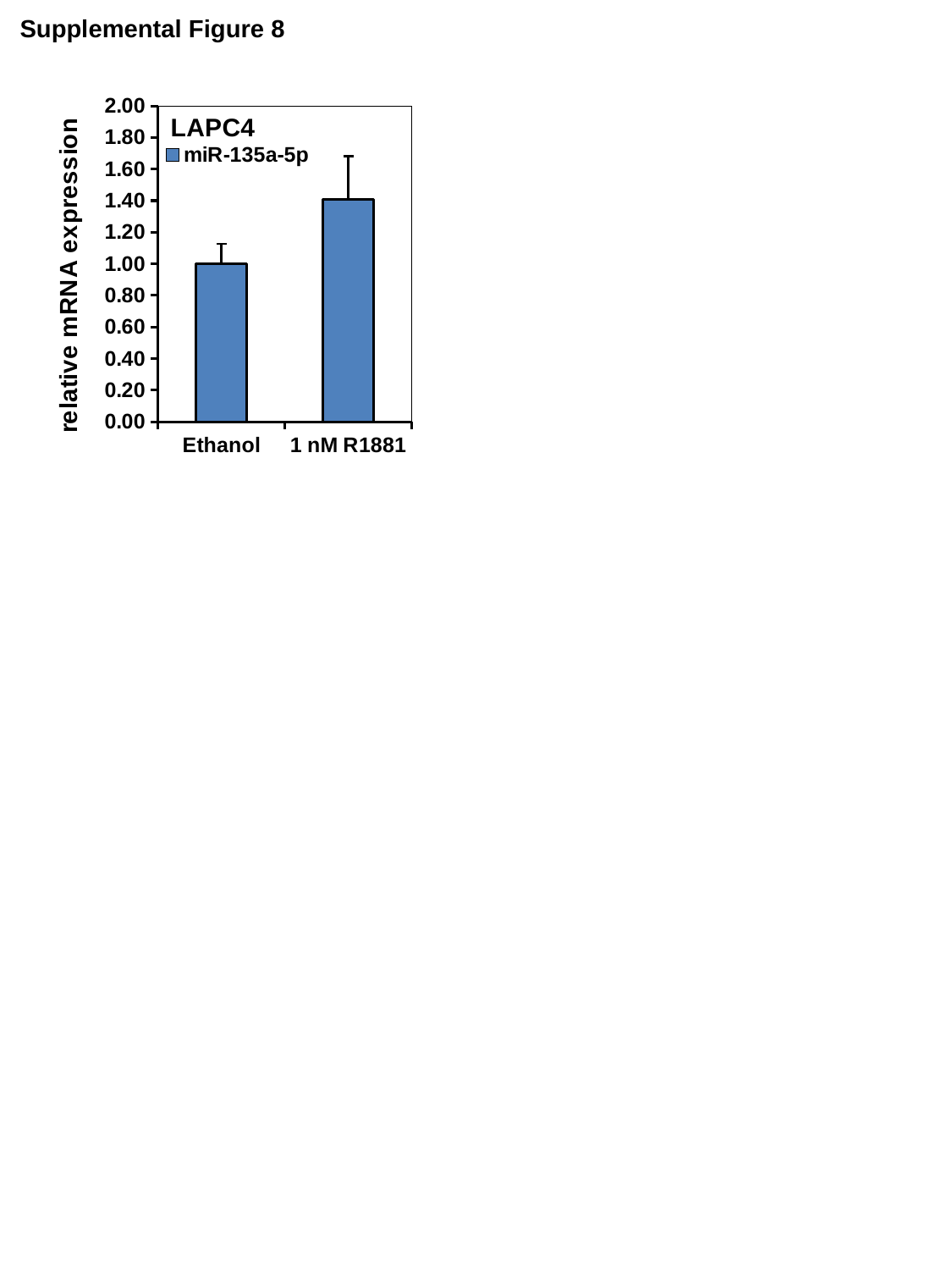
How many series does the chart's legend list? 1 Do the values rise or fall from Ethanol to 1 nM R1881? rise Which category has the highest relative mRNA expression? 1 nM R1881 How many categories are shown on the x axis of the chart? 2 Which is larger, the value for Ethanol or the value for 1 nM R1881? 1 nM R1881 Is the value for 1 nM R1881 greater or less than 1.60? less What is the title of the chart's y axis? relative mRNA expression What is the relative mRNA expression value for Ethanol? 1.00 Which category has the lowest relative mRNA expression? Ethanol Is the value for 1 nM R1881 greater or less than 1.20? greater What kind of chart is shown on the slide? bar chart What series name is listed in the chart's legend? miR-135a-5p